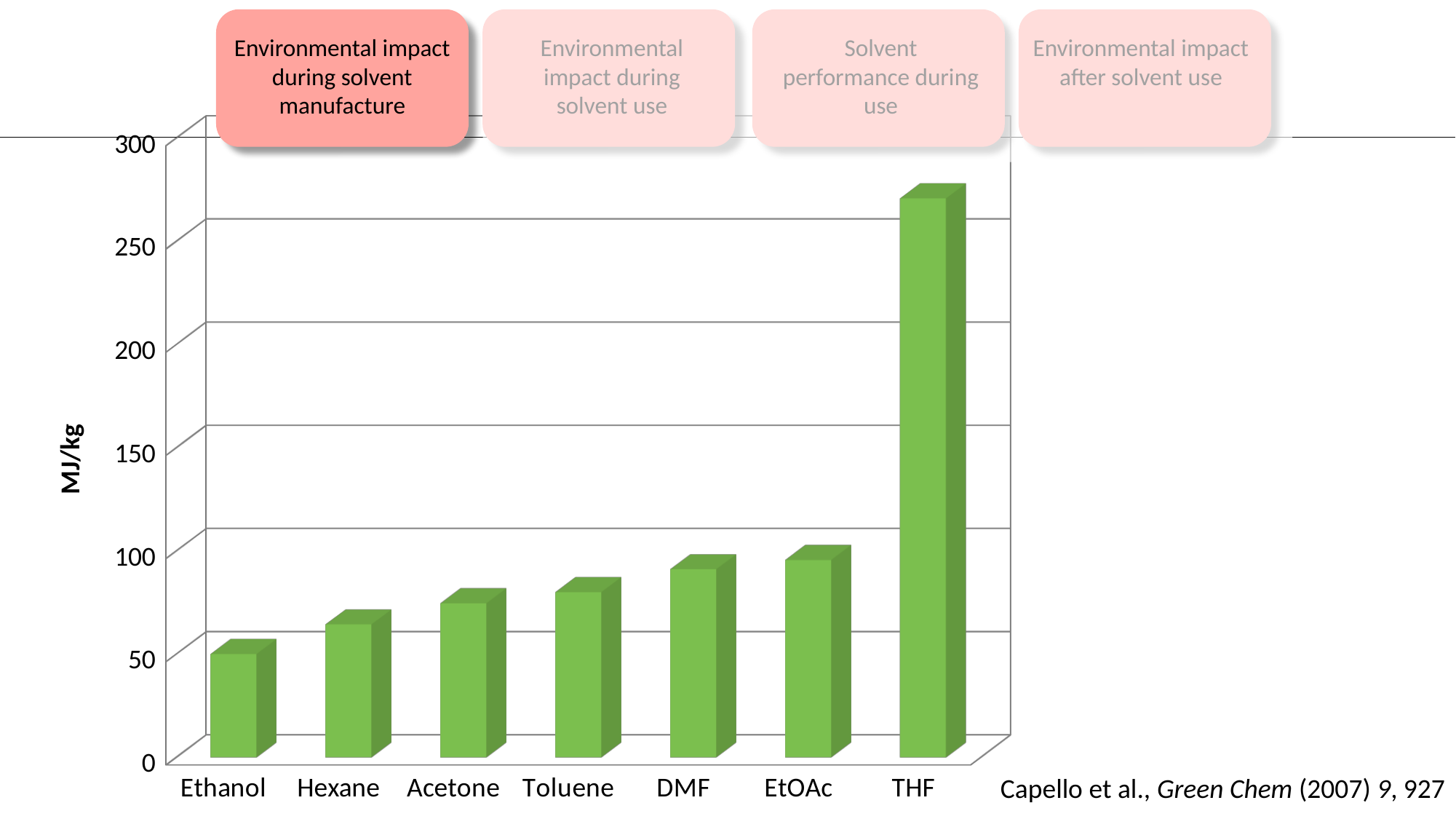
What is the label on the vertical axis of the chart? MJ/kg Is the value for DMF greater or less than 50? greater Which has a larger value, Ethanol or Acetone? Acetone Is the value for THF greater or less than 250? greater Which solvent has the highest value on the chart? THF Which solvent has the lowest value on the chart? Ethanol Which has a larger value, DMF or Hexane? DMF Is the value for THF greater or less than 300? less Do the bar values rise or fall from left to right across the chart? rise What kind of chart is shown on the slide? bar chart How many solvents are plotted on the chart? 7